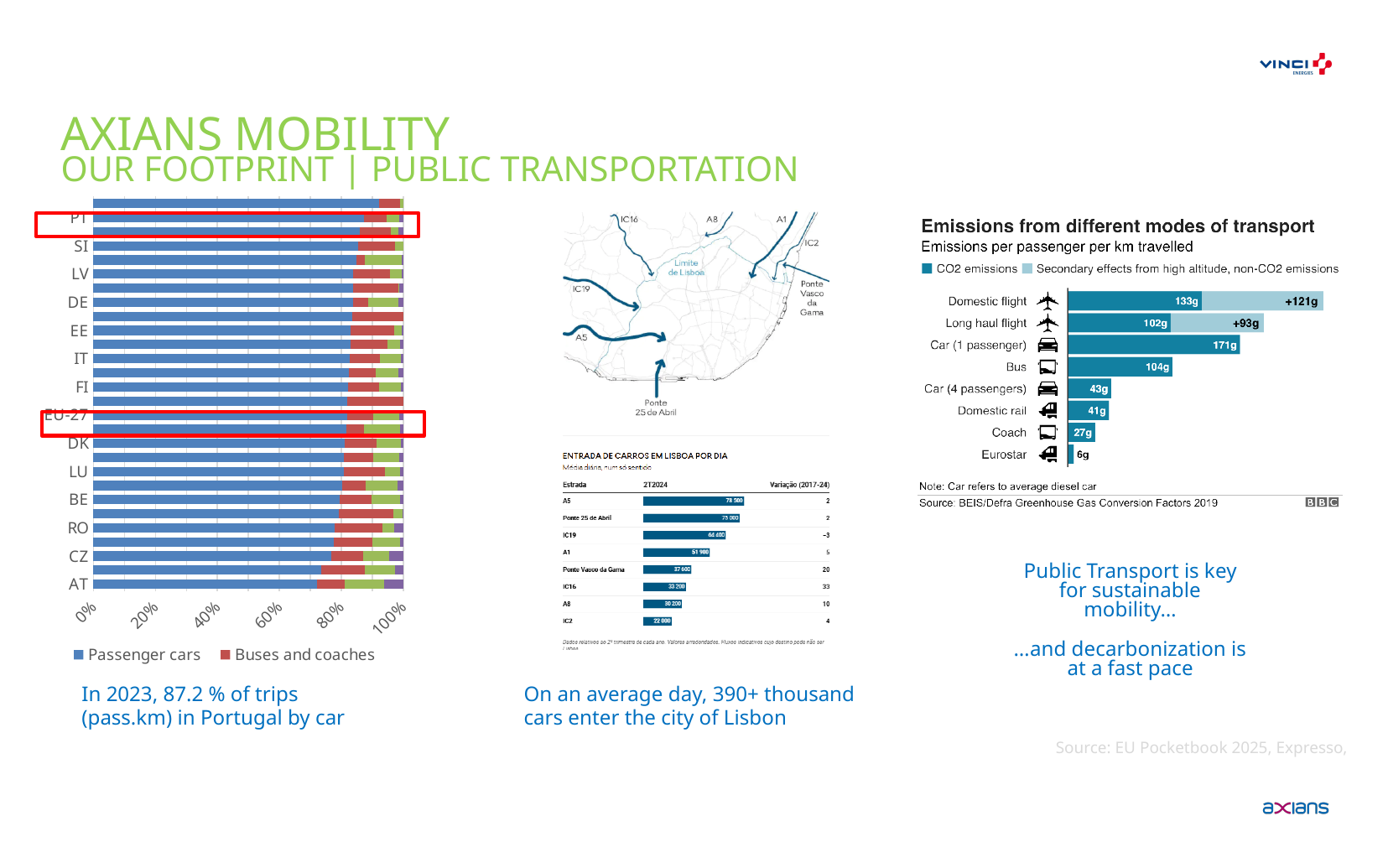
In the 'Emissions from different modes of transport' chart, how many series does the legend list? 2 In the 'Emissions from different modes of transport' chart, what is the total of the Domestic flight bar (CO2 emissions plus secondary effects)? 254g In the 'Entrada de carros em Lisboa por dia' chart, which road has the highest value for 2T2024? A5 In the chart on the left of the slide, is the Passenger cars value for AT greater or less than 80%? less In the 'Emissions from different modes of transport' chart, what is the CO2 emissions value for Car (1 passenger)? 171g In the 'Emissions from different modes of transport' chart, which mode of transport has the highest CO2 emissions? Car (1 passenger) In the 'Emissions from different modes of transport' chart, how many modes of transport are listed? 8 In the 'Entrada de carros em Lisboa por dia' chart, what is the 2T2024 value for IC19? 64 400 In the 'Emissions from different modes of transport' chart, what is the CO2 emissions value for Bus? 104g What kind of chart is the chart on the left of the slide showing countries such as PT, SI and LV? Stacked bar chart In the 'Emissions from different modes of transport' chart, what is the difference between the CO2 emissions of Car (1 passenger) and Bus? 67g In the 'Emissions from different modes of transport' chart, which mode of transport has the lowest CO2 emissions? Eurostar